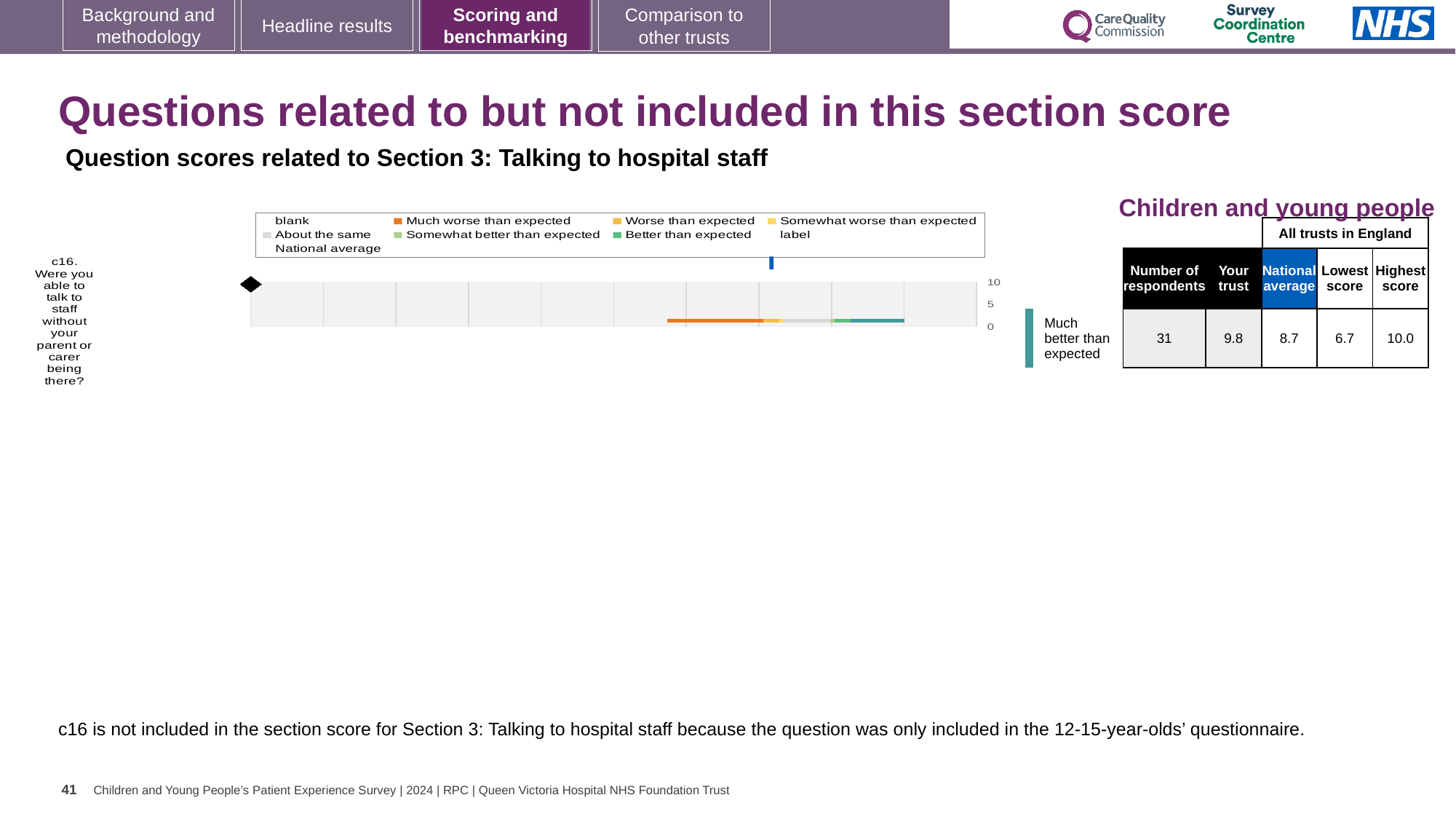
What is the highest score among all trusts in England for c16? 10.0 By how much does the trust's c16 score exceed the national average? 1.1 What is the 'Your trust' score for c16? 9.8 What is the difference between the highest and lowest scores for c16 across all trusts in England? 3.3 What is the lowest score among all trusts in England for c16? 6.7 Which benchmarking category is the trust's c16 result labelled as? Much better than expected How many questions are plotted in the chart? 1 How many entries does the chart legend list? 9 What kind of chart is used to show the c16 result? bar chart What is the national average score for c16? 8.7 How many respondents answered c16? 31 Which is higher for c16: the trust's score or the national average? Your trust